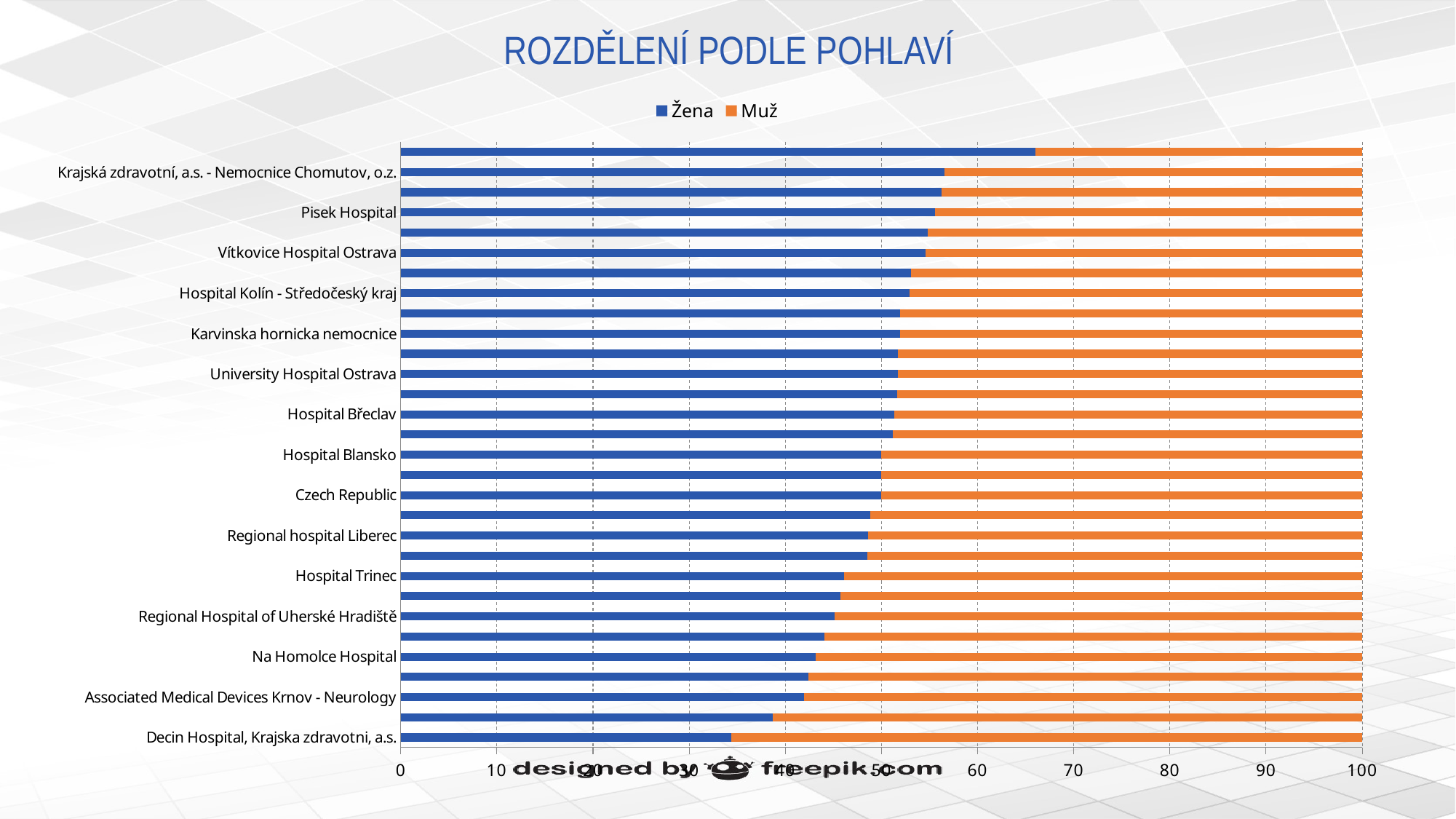
Which has the larger Žena value, Pisek Hospital or Na Homolce Hospital? Pisek Hospital What type of chart is shown on the slide? Stacked bar chart Is the Žena value for Hospital Trinec greater or less than 50? less Is the Žena value for Pisek Hospital greater or less than 50? greater What are the two series named in the legend? Žena and Muž Moving from the top of the chart to the bottom, does the Žena share rise or fall? Fall Is the Žena value for Decin Hospital, Krajska zdravotni, a.s. greater or less than 40? less Which category has the highest Muž value? Decin Hospital, Krajska zdravotni, a.s. What is the title of the chart? ROZDĚLENÍ PODLE POHLAVÍ How many series does the legend list? 2 Which category has the lowest Žena value? Decin Hospital, Krajska zdravotni, a.s.